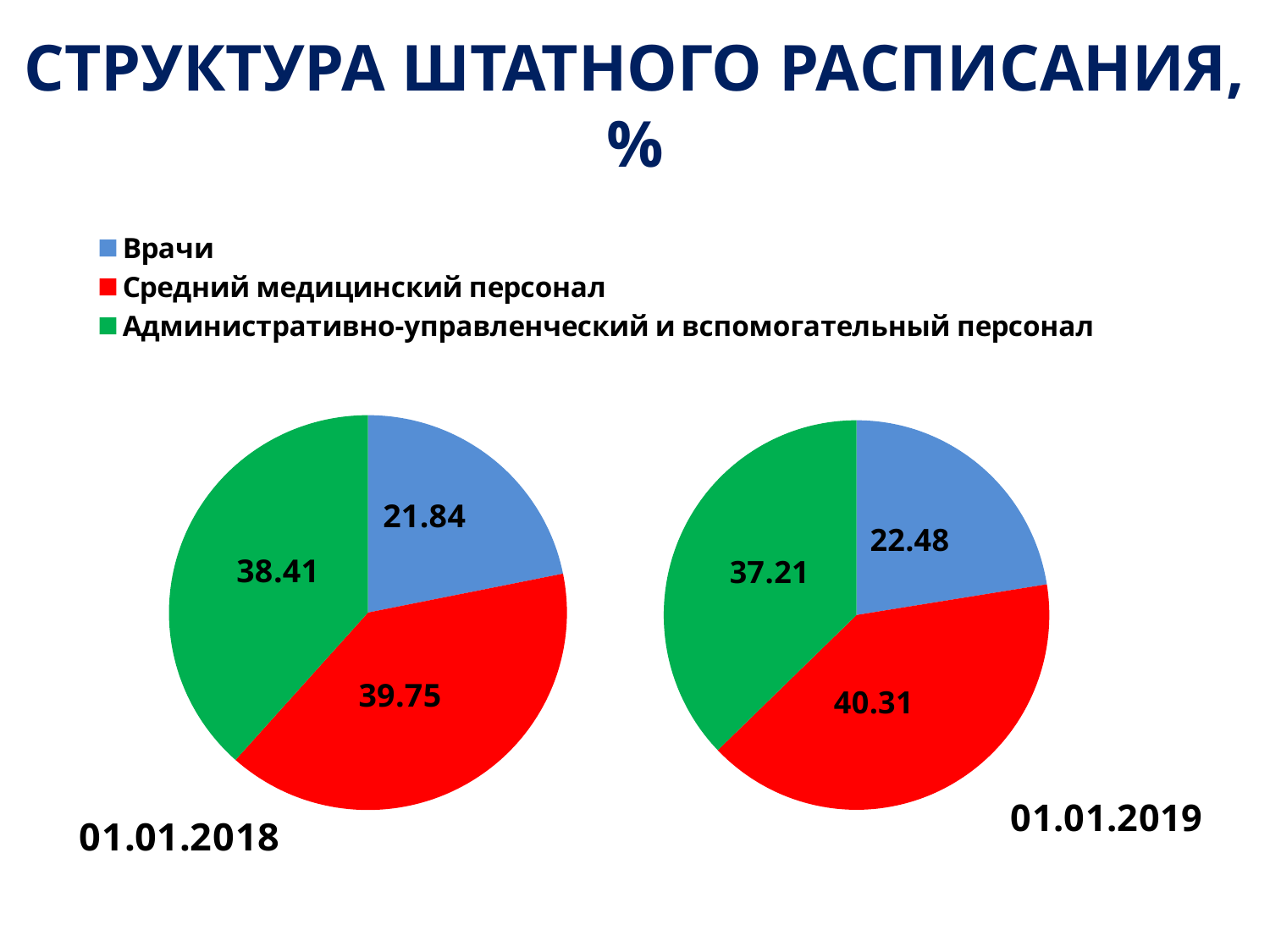
How many slices does each pie chart have? 3 In the 01.01.2018 pie chart, which is larger: Средний медицинский персонал or Административно-управленческий и вспомогательный персонал? Средний медицинский персонал Which colour represents Врачи in the pie charts? Blue What is the difference between the value for Врачи in the 01.01.2019 pie chart and in the 01.01.2018 pie chart? 0.64 What kind of charts are shown on the slide? Pie charts In the 01.01.2019 pie chart, what is the value for Средний медицинский персонал? 40.31 In the 01.01.2018 pie chart, what is the value for Врачи? 21.84 In the 01.01.2018 pie chart, which category has the smallest share? Врачи In the 01.01.2019 pie chart, which category has the largest share? Средний медицинский персонал In the 01.01.2019 pie chart, what is the value for Административно-управленческий и вспомогательный персонал? 37.21 In the 01.01.2018 pie chart, what is the value for Административно-управленческий и вспомогательный персонал? 38.41 How many categories does the legend list? 3